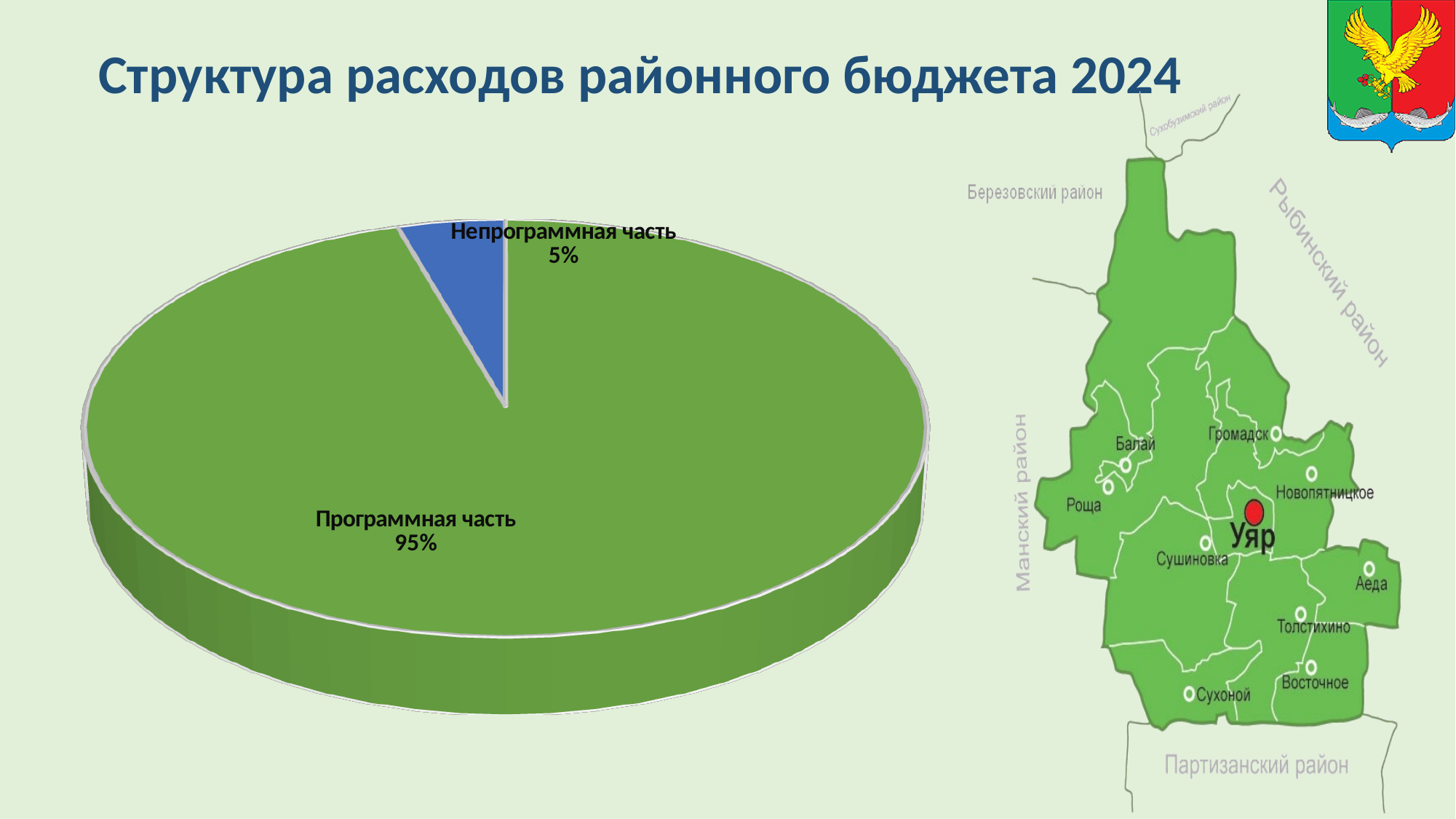
What is the title of the slide? Структура расходов районного бюджета 2024 Which is larger, Программная часть or Непрограммная часть? Программная часть How many slices does the pie chart have? 2 What colour is the slice for Непрограммная часть? Blue Which category has the smallest slice of the pie? Непрограммная часть What share of the pie does Программная часть represent? 95% What kind of chart is shown on the slide? Pie chart What share of the pie does Непрограммная часть represent? 5% What is the difference in percentage points between Программная часть and Непрограммная часть? 90 Which category has the largest slice of the pie? Программная часть